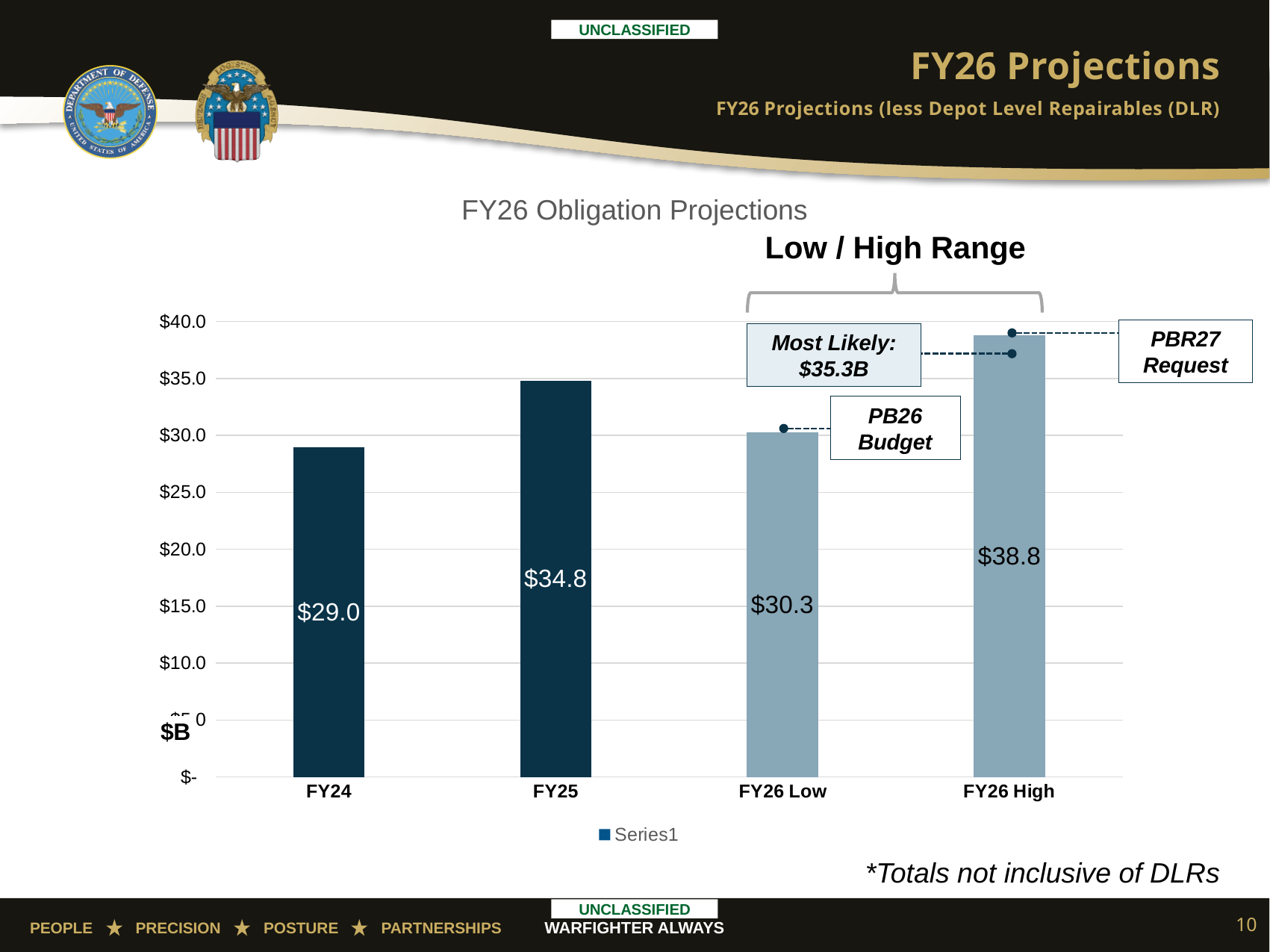
What is the value for FY24? $29.0 What is the value for FY26 Low? $30.3 Which category has the lowest value? FY24 What is the value for FY26 High? $38.8 What is the difference between the FY25 and FY24 values? $5.8 What is the value for FY25? $34.8 What is the difference between the FY26 High and FY26 Low values? $8.5 Which category has the highest value? FY26 High What is the title of the chart? FY26 Obligation Projections What kind of chart is shown on the slide? Bar chart How many categories are shown on the x axis? 4 Which is larger, the value for FY25 or the value for FY26 Low? FY25